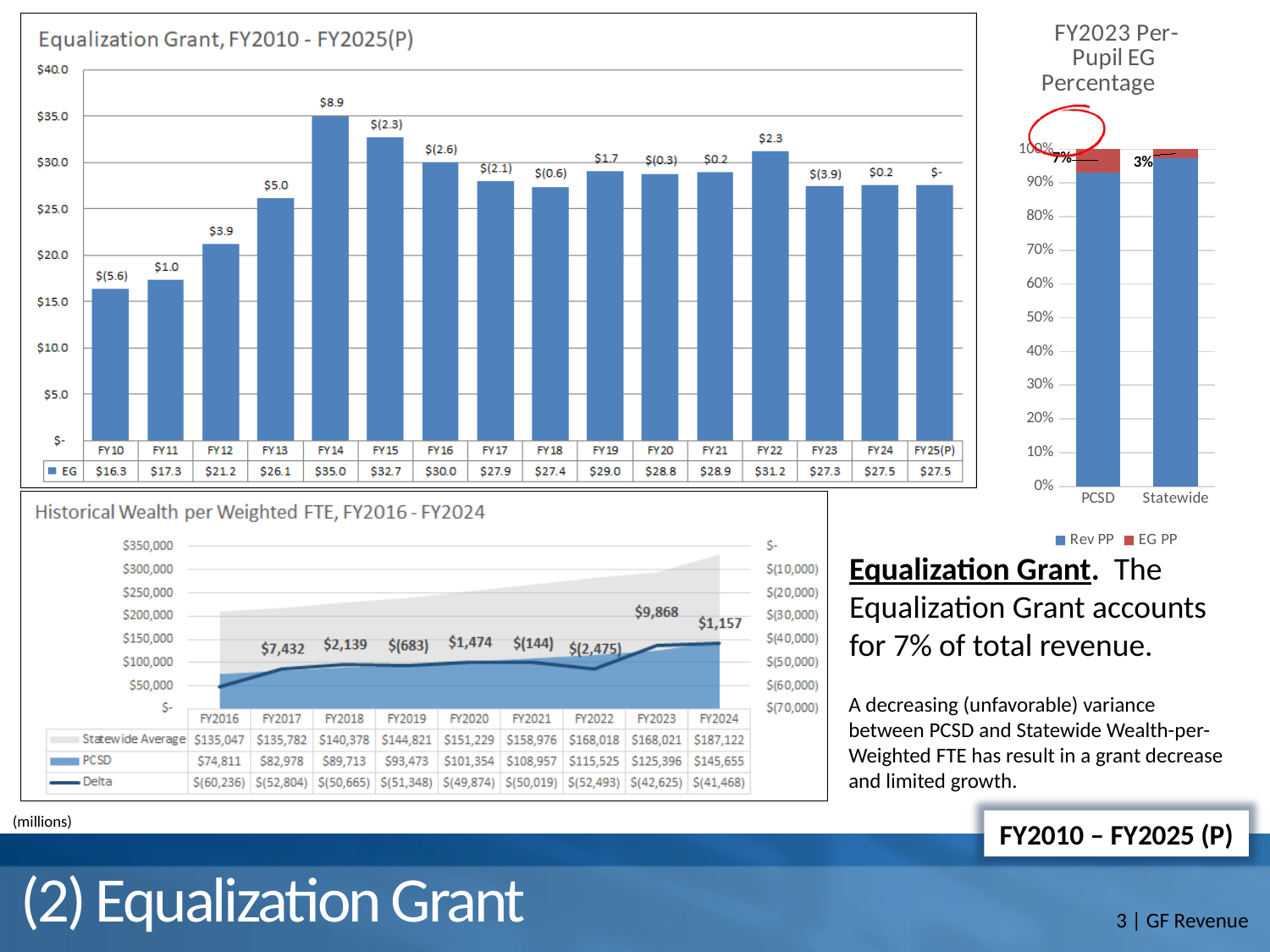
In the 'Equalization Grant, FY2010 - FY2025(P)' chart, which fiscal year has the lowest EG value? FY10 What kind of chart is the 'Equalization Grant, FY2010 - FY2025(P)' chart? Bar chart In the 'Equalization Grant, FY2010 - FY2025(P)' chart, which fiscal year has the highest EG value? FY14 In the 'Historical Wealth per Weighted FTE, FY2016 - FY2024' chart, do the PCSD values rise or fall from FY2016 to FY2024? Rise In the 'Equalization Grant, FY2010 - FY2025(P)' chart, how many fiscal years are plotted? 16 In the 'Equalization Grant, FY2010 - FY2025(P)' chart, is the EG value for FY12 greater or less than $20.0? greater In the 'Historical Wealth per Weighted FTE, FY2016 - FY2024' chart, what is the Statewide Average value for FY2024? $187,122 In the 'Equalization Grant, FY2010 - FY2025(P)' chart, what is the EG value for FY14? $35.0 In the 'FY2023 Per-Pupil EG Percentage' chart, what is the EG PP percentage for Statewide? 3% In the 'Historical Wealth per Weighted FTE, FY2016 - FY2024' chart, what is the PCSD value for FY2020? $101,354 In the 'Equalization Grant, FY2010 - FY2025(P)' chart, what is the difference between the EG values for FY22 and FY23? $3.9 In the 'Historical Wealth per Weighted FTE, FY2016 - FY2024' chart, how many series are listed in the legend? 3